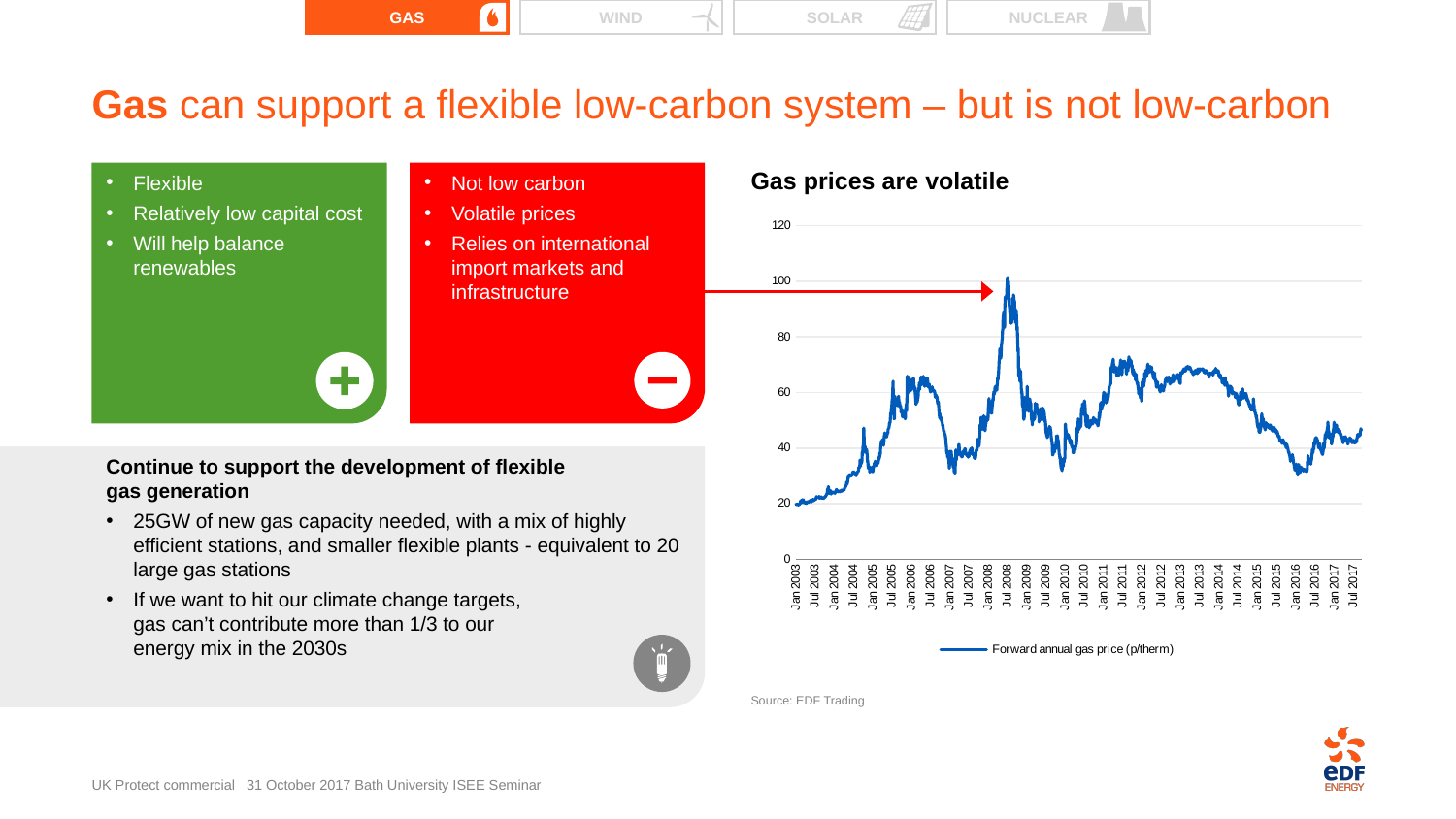
Is the forward annual gas price at Jan 2016 greater or less than 60? less Around which date does the forward annual gas price reach its highest point? Jul 2008 Is the forward annual gas price at Jan 2003 greater or less than 40? less What is the title of the chart on the right of the slide? Gas prices are volatile Around which date is the forward annual gas price at its lowest? Jan 2003 Does the forward annual gas price rise or fall between Jan 2014 and Jan 2016? fall Is the peak of the forward annual gas price around Jul 2008 greater or less than 80? greater Does the forward annual gas price rise or fall between Jan 2003 and Jan 2006? rise What kind of chart is shown under the heading 'Gas prices are volatile'? Line chart How many series does the legend of the gas price chart list? 1 What is the series name shown in the legend of the gas price chart? Forward annual gas price (p/therm)